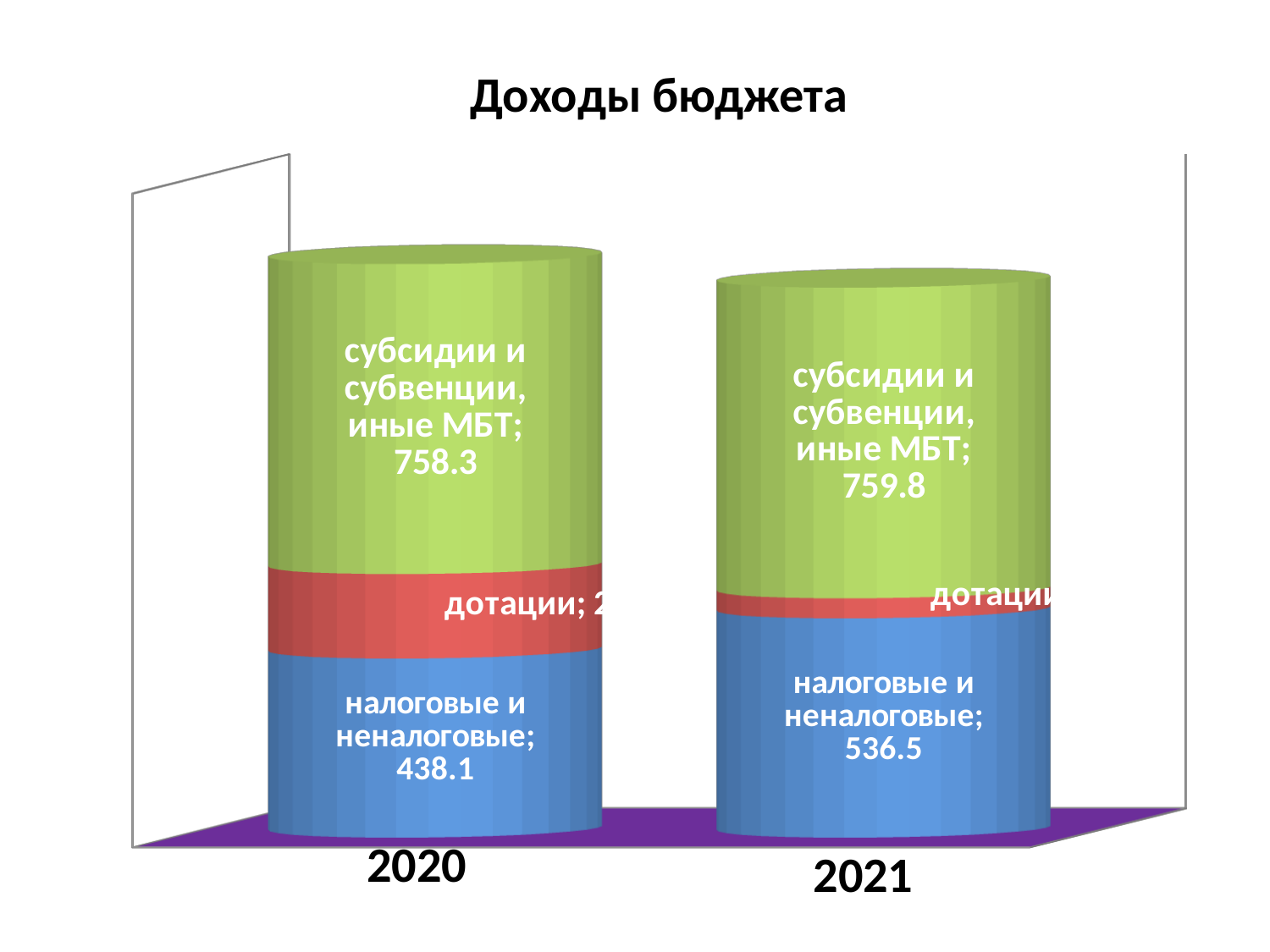
Which segment is the largest in the 2021 bar? субсидии и субвенции, иные МБТ By how much did налоговые и неналоговые increase from 2020 to 2021? 98.4 What is the value of налоговые и неналоговые for 2020? 438.1 What is the value of субсидии и субвенции, иные МБТ for 2021? 759.8 What is the value of субсидии и субвенции, иные МБТ for 2020? 758.3 What is the difference between субсидии и субвенции, иные МБТ in 2021 and in 2020? 1.5 What is the title of the chart? Доходы бюджета Which year has the larger value for налоговые и неналоговые, 2020 or 2021? 2021 What kind of chart is shown on the slide? stacked bar chart What is the value of налоговые и неналоговые for 2021? 536.5 How many years (categories) are shown on the chart? 2 In 2020, which is larger: субсидии и субвенции, иные МБТ or налоговые и неналоговые? субсидии и субвенции, иные МБТ